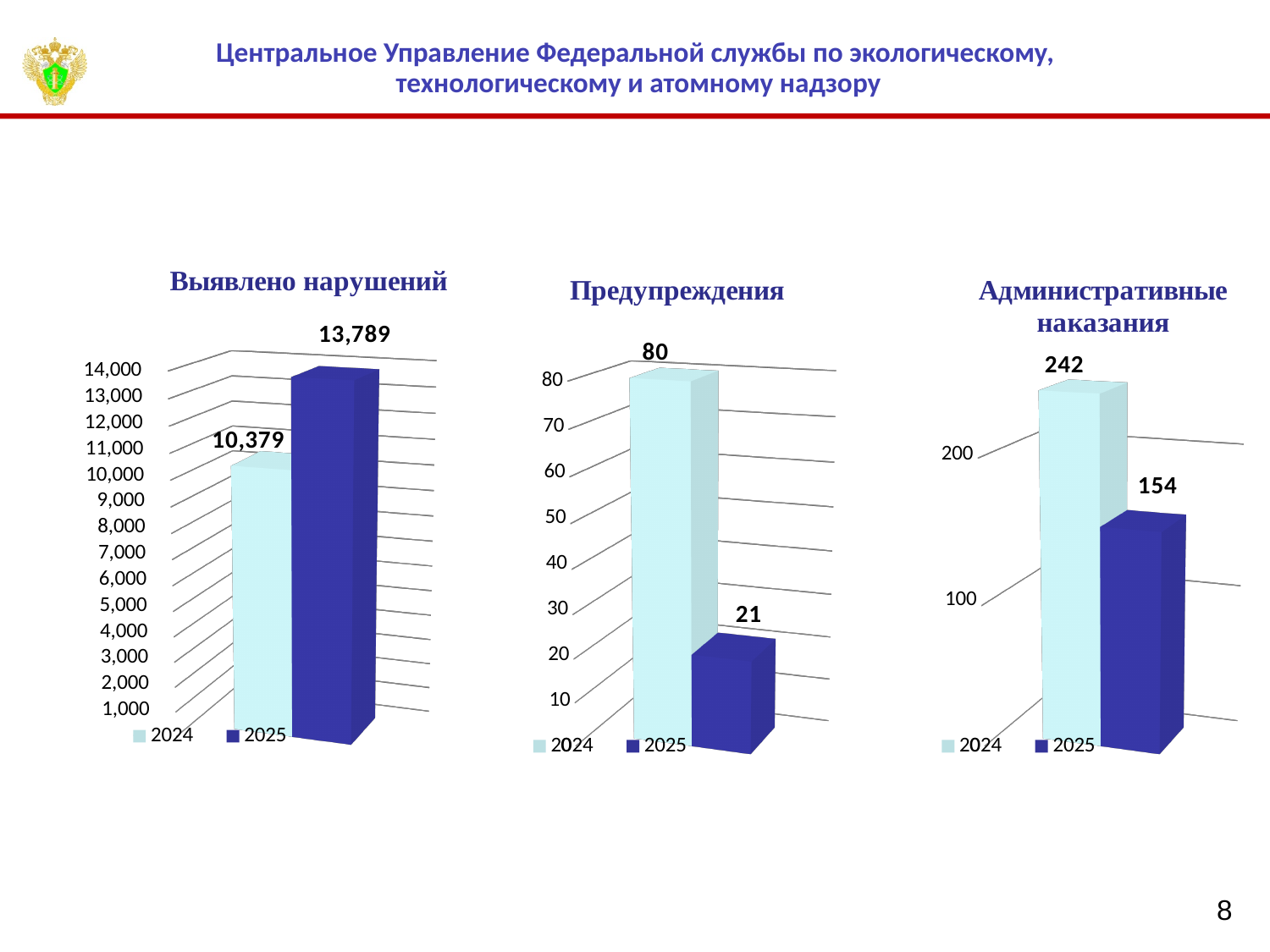
In the "Административные наказания" chart, what is the value for 2024? 242 In the "Выявлено нарушений" chart, what is the difference between the 2025 and 2024 values? 3,410 In the "Административные наказания" chart, what is the value for 2025? 154 What kind of chart is the "Административные наказания" chart? Bar chart In the "Предупреждения" chart, which year has the lower value? 2025 How many series does the legend of the "Предупреждения" chart list? 2 In the "Предупреждения" chart, what is the value for 2025? 21 In the "Административные наказания" chart, what is the difference between the 2024 and 2025 values? 88 In the "Предупреждения" chart, what is the value for 2024? 80 In the "Выявлено нарушений" chart, what is the value for 2025? 13,789 In the "Выявлено нарушений" chart, what is the value for 2024? 10,379 In the "Выявлено нарушений" chart, which year has the higher value? 2025